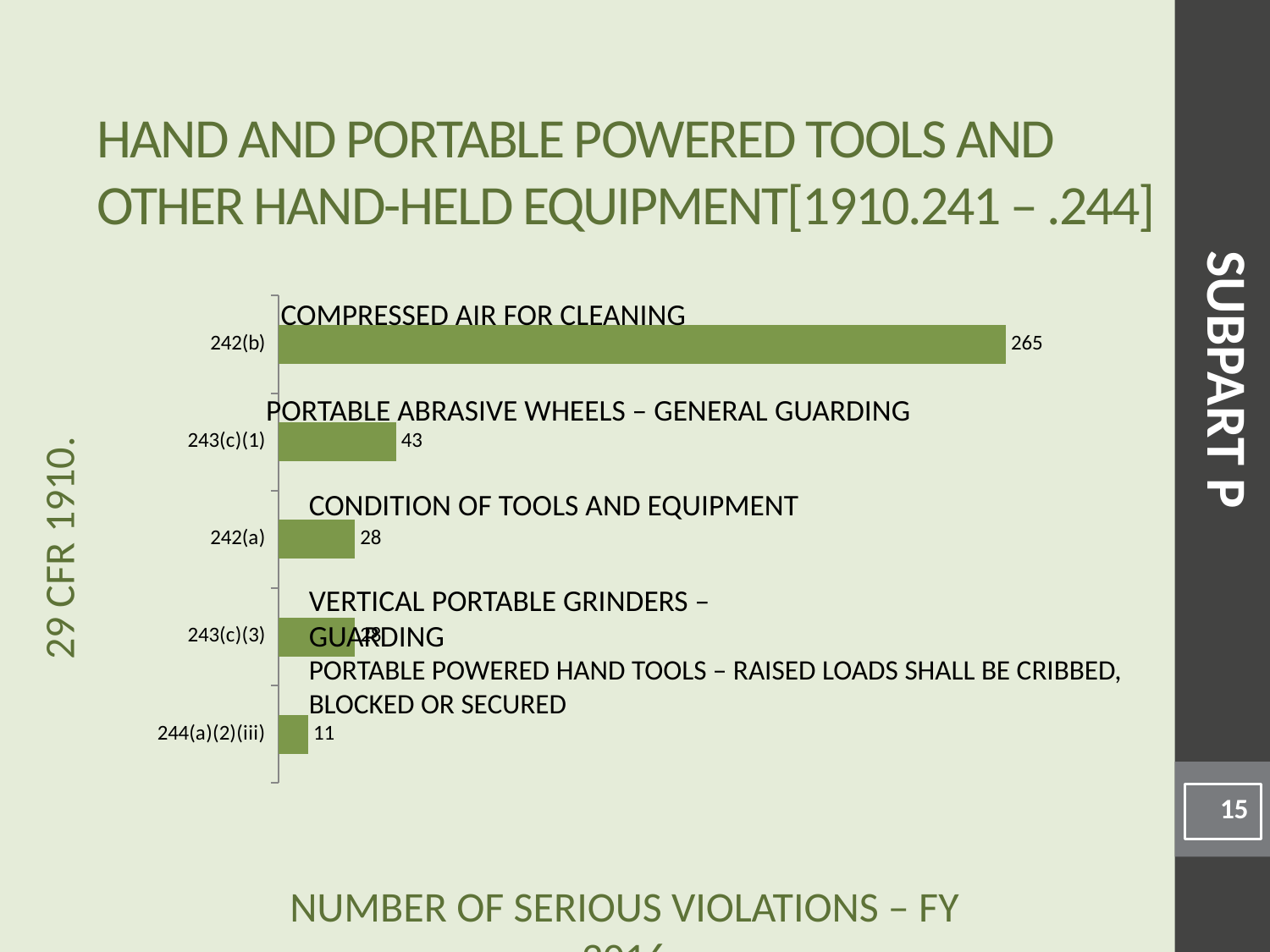
What kind of chart is shown on the slide? Bar chart What is the value for 244(a)(2)(iii)? 11 Which is larger, the value for 242(b) or the value for 243(c)(1)? 242(b) Which category has the highest value? 242(b) What is the value for 243(c)(1)? 43 How many categories are shown in the chart? 5 What is the difference between the values for 243(c)(1) and 242(a)? 15 Which category has the lowest value? 244(a)(2)(iii) What is the difference between the values for 242(b) and 243(c)(1)? 222 What is the value for 242(a)? 28 What description is written above the bar for 242(b)? COMPRESSED AIR FOR CLEANING What is the value for 242(b)? 265